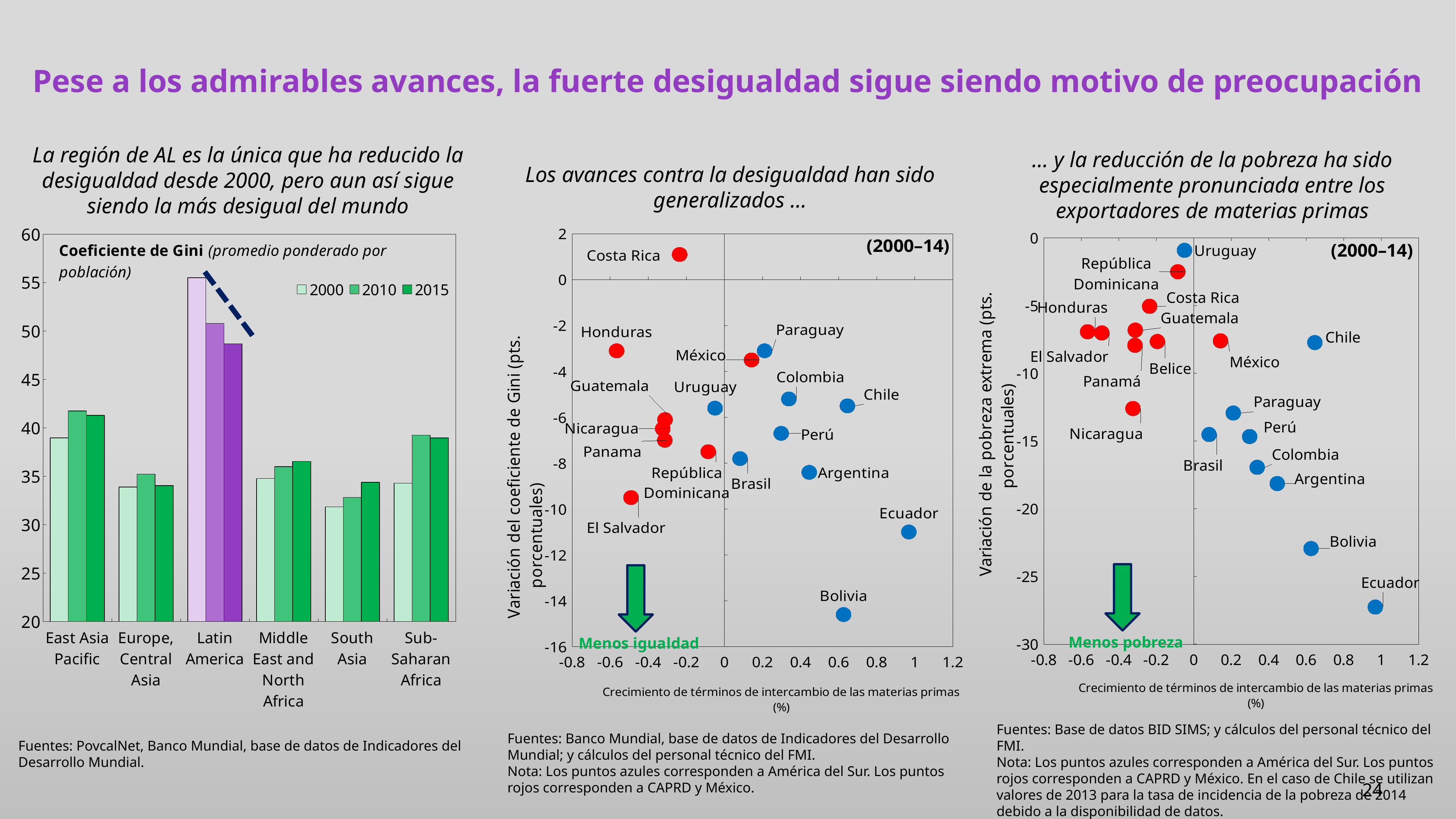
In the left-hand Coeficiente de Gini bar chart, do the values for Latin America rise or fall from 2000 to 2015? fall In the left-hand Coeficiente de Gini bar chart, how many series does the legend list? 3 What kind of chart is the middle chart titled 'Los avances contra la desigualdad han sido generalizados ...'? scatter chart What kind of chart is the left-hand chart showing the Coeficiente de Gini by region? bar chart In the middle scatter chart, which country has the lowest variation of the Gini coefficient? Bolivia In the left-hand Coeficiente de Gini bar chart, is the 2000 value for South Asia greater or less than 30? greater In the left-hand Coeficiente de Gini bar chart, which region has the lowest value in 2000? South Asia In the left-hand Coeficiente de Gini bar chart, is the 2015 value for Latin America greater or less than 50? less In the left-hand Coeficiente de Gini bar chart, which region has the highest value in 2015? Latin America In the right-hand scatter chart on extreme poverty, is the value for Ecuador greater or less than -25? less In the right-hand scatter chart on extreme poverty, which country has the lowest variation in extreme poverty? Ecuador In the left-hand Coeficiente de Gini bar chart, how many regions are shown on the x axis? 6